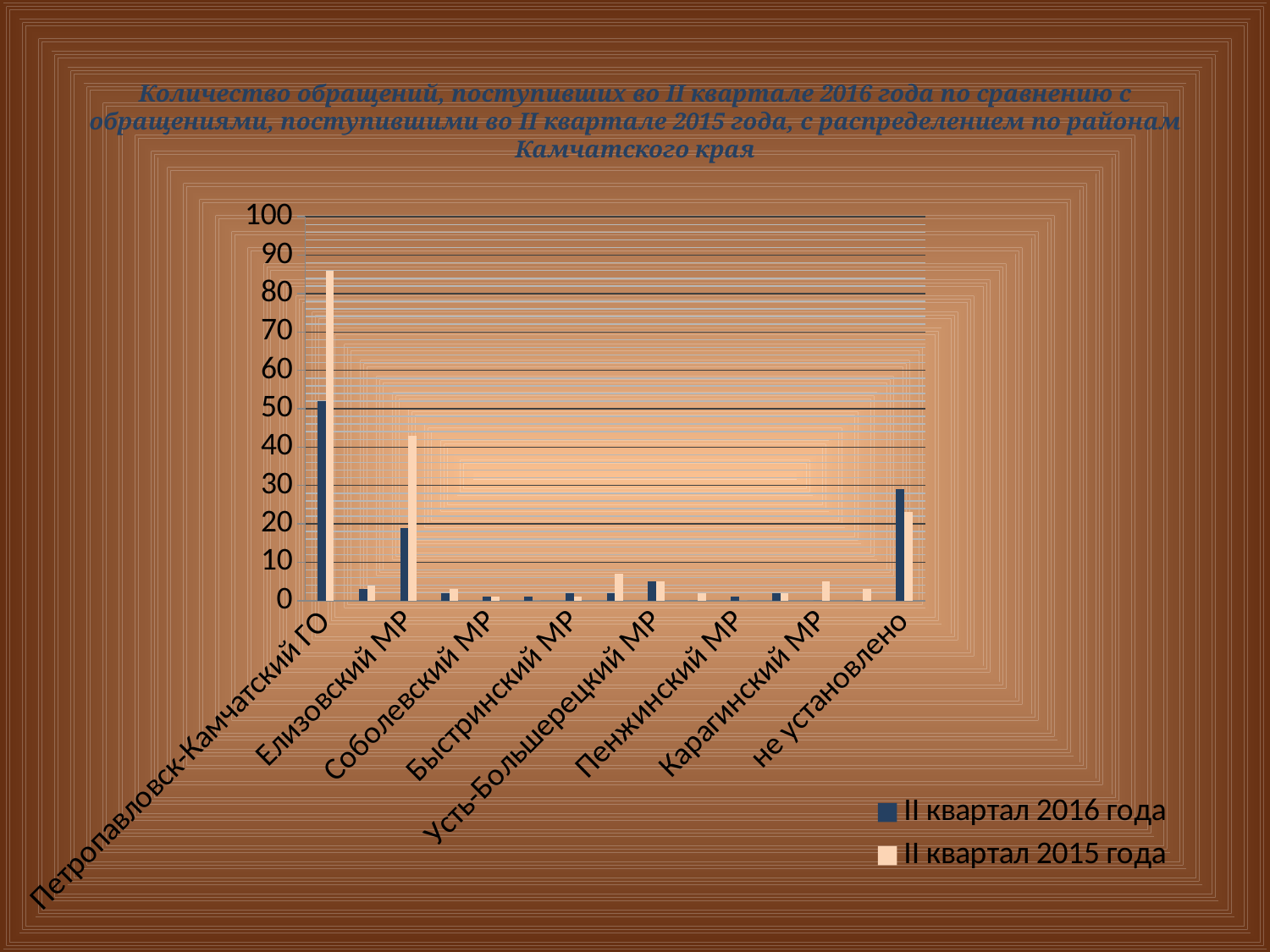
Is the value for Петропавловск-Камчатский ГО in 'II квартал 2016 года' greater or less than 40? greater Is the value for Петропавловск-Камчатский ГО in 'II квартал 2015 года' greater or less than 80? greater Which category has the highest value for the series 'II квартал 2015 года'? Петропавловск-Камчатский ГО What kind of chart is shown on the slide? bar chart Is the value for Елизовский МР in 'II квартал 2015 года' greater or less than 30? greater For the category 'не установлено', which series has the larger value: 'II квартал 2016 года' or 'II квартал 2015 года'? II квартал 2016 года What are the two series named in the legend? II квартал 2016 года and II квартал 2015 года How many series does the chart's legend list? 2 Which category has the highest value for the series 'II квартал 2016 года'? Петропавловск-Камчатский ГО For Петропавловск-Камчатский ГО, which series has the larger value: 'II квартал 2016 года' or 'II квартал 2015 года'? II квартал 2015 года